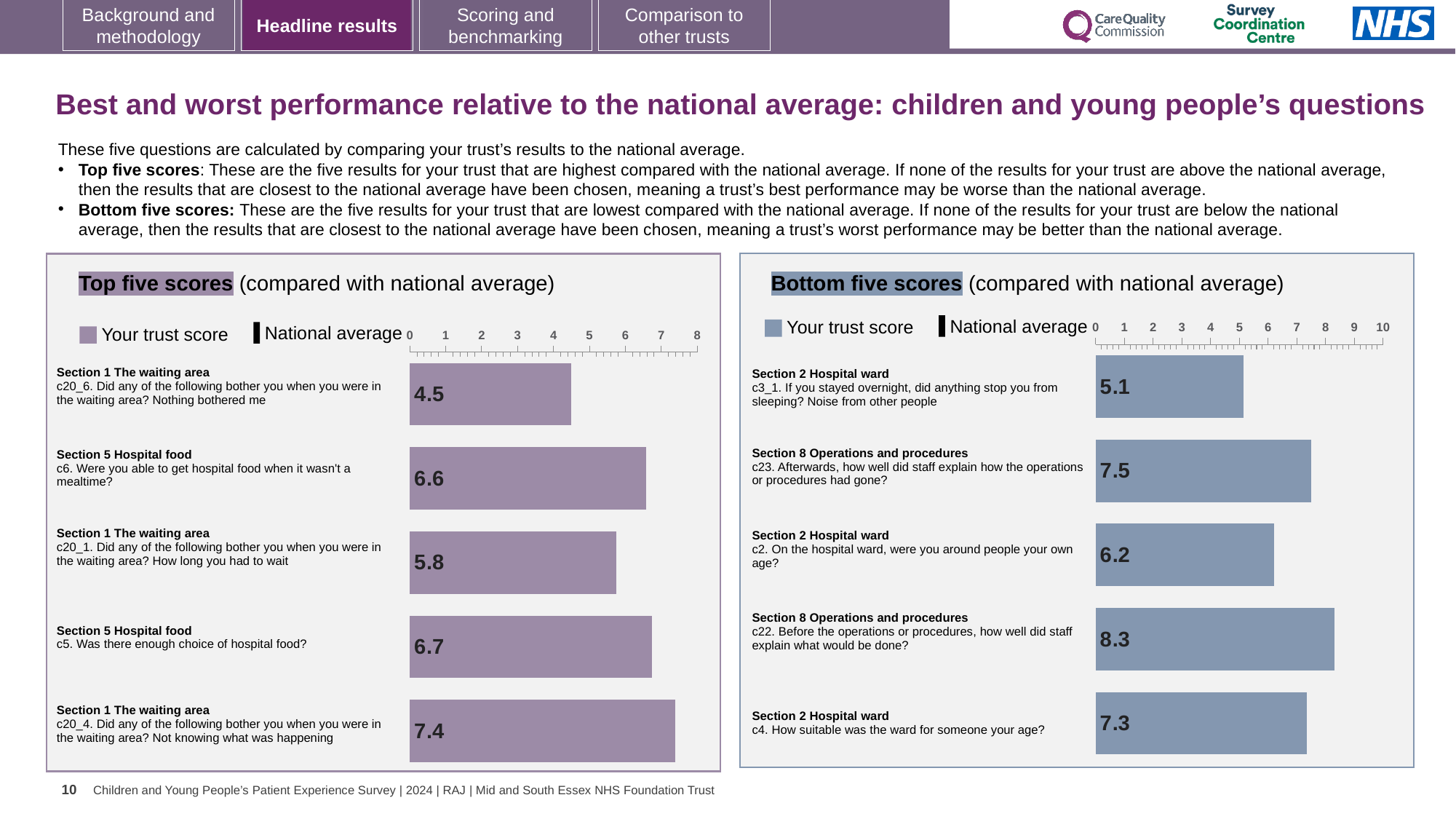
In the Bottom five scores chart, what is the trust score for c22 (how well did staff explain what would be done)? 8.3 In the Top five scores chart, what is the difference between the trust scores for c20_4 and c20_6? 2.9 In the Top five scores chart, what is the trust score for c5 (Was there enough choice of hospital food)? 6.7 In the Top five scores chart, what is the trust score for c20_6 (Nothing bothered me in the waiting area)? 4.5 What is the maximum value shown on the axis of the Bottom five scores chart? 10 In the Bottom five scores chart, what is the difference between the trust scores for c22 and c3_1? 3.2 How many bars are shown in the Top five scores chart? 5 In the Bottom five scores chart, which question has the lowest trust score? c3_1. Noise from other people In the Top five scores chart, which question has the highest trust score? c20_4. Not knowing what was happening In the Bottom five scores chart, which has the larger trust score: c23 or c2? c23 In the Bottom five scores chart, what is the trust score for c4 (How suitable was the ward for someone your age)? 7.3 What type of chart is used for the Bottom five scores? Bar chart